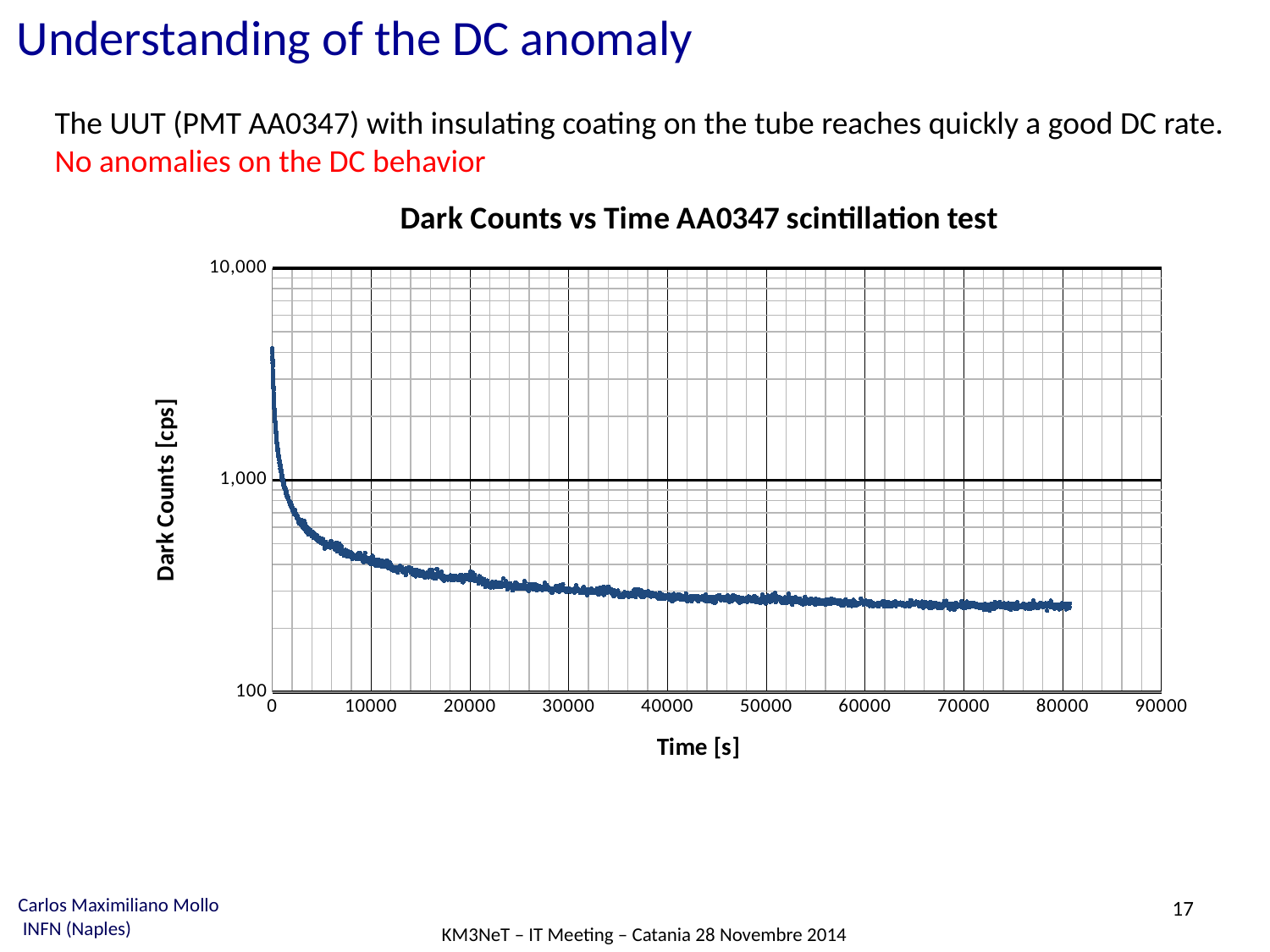
What is the title of the chart? Dark Counts vs Time AA0347 scintillation test Is the dark count value at time 0 greater or less than 1,000 cps? greater What kind of chart is shown on the slide? scatter chart Do the dark counts rise or fall as time increases along the x axis? fall Is the dark count value at time 0 greater or less than 10,000 cps? less What is the label of the y axis of the chart? Dark Counts [cps] Is the dark count value at time 10000 s greater or less than 1,000 cps? less